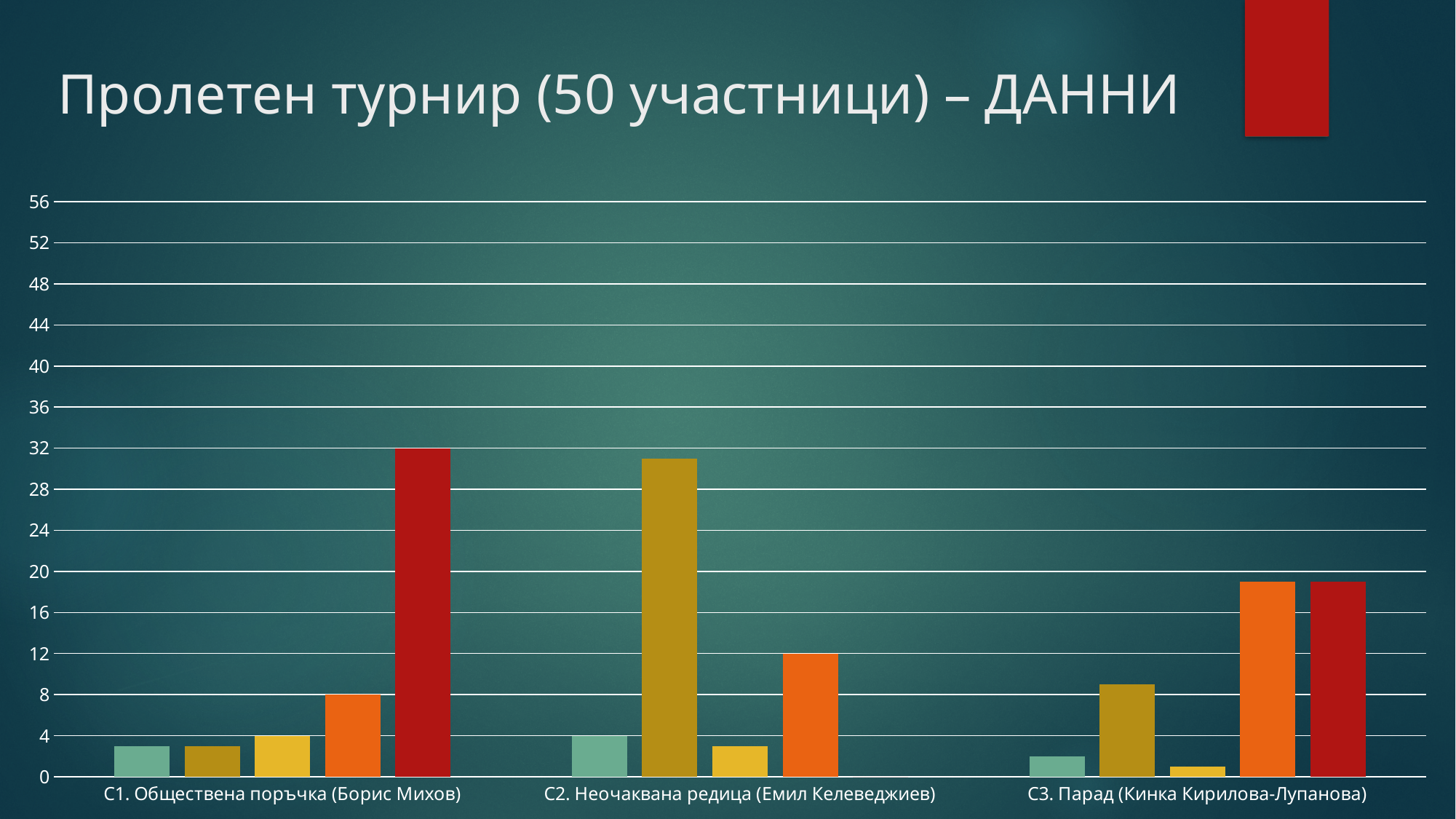
Which bar is the highest for 'С1. Обществена поръчка (Борис Михов)'? the red bar What is the value of the orange bar for 'С1. Обществена поръчка (Борис Михов)'? 8 What is the difference between the red bar and the orange bar for 'С1. Обществена поръчка (Борис Михов)'? 24 What is the value of the red bar for 'С1. Обществена поръчка (Борис Михов)'? 32 How many bars are plotted for each category in the chart? 5 What is the value of the orange bar for 'С2. Неочаквана редица (Емил Келеведжиев)'? 12 How many categories are shown on the x axis of the chart? 3 Which is larger: the red bar for 'С1. Обществена поръчка (Борис Михов)' or the orange bar for 'С2. Неочаквана редица (Емил Келеведжиев)'? the red bar for С1. Обществена поръчка (Борис Михов) What is the title of the slide containing the chart? Пролетен турнир (50 участници) – ДАННИ Which bar is the lowest for 'С3. Парад (Кинка Кирилова-Лупанова)'? the yellow bar Is the value of the olive bar for 'С2. Неочаквана редица (Емил Келеведжиев)' greater or less than 28? greater What kind of chart is shown on the slide? bar chart